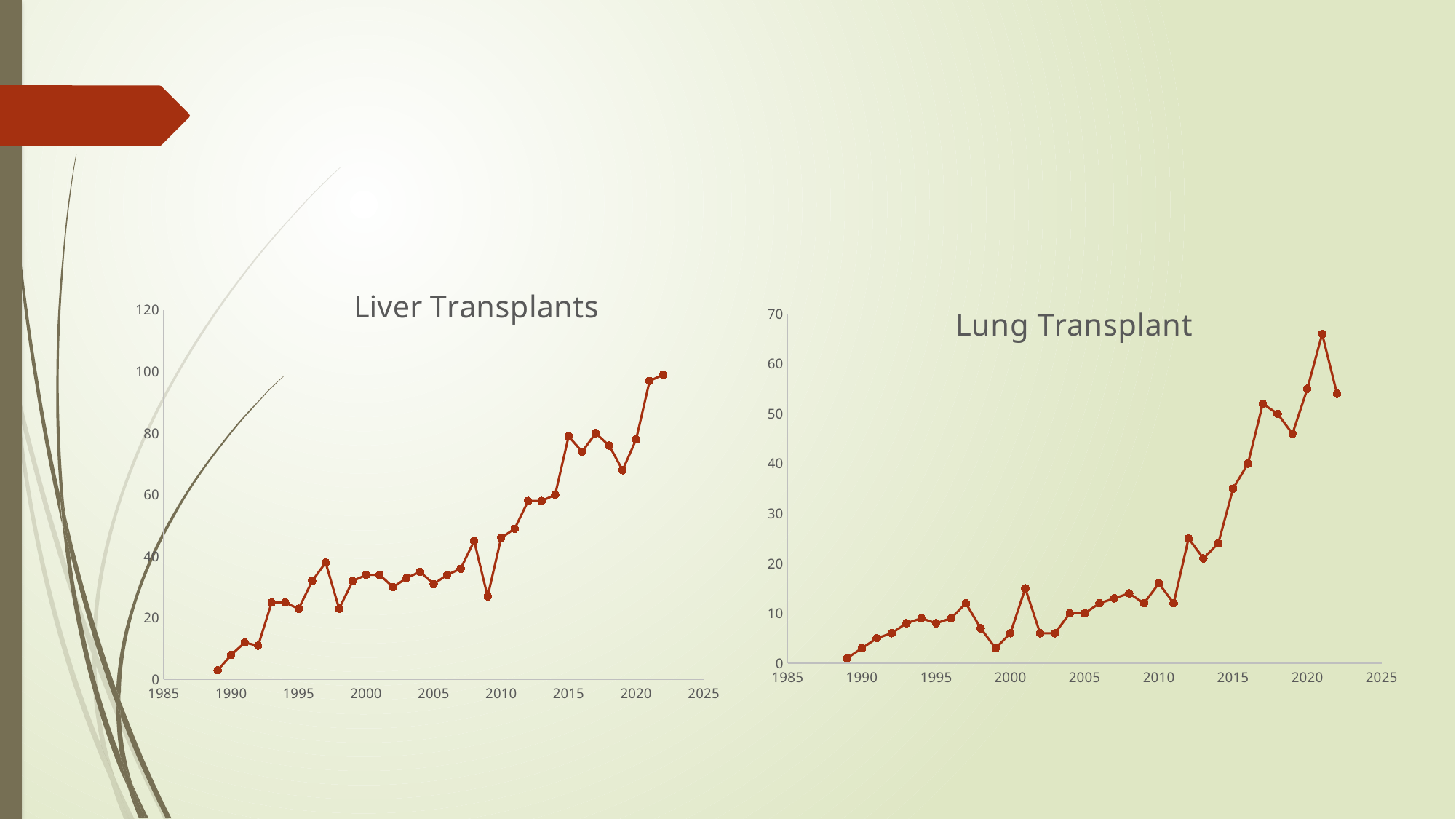
In the Lung Transplant chart, is the value for 2022 greater or less than 50? greater In the Lung Transplant chart, is the value for 1999 greater or less than 10? less In the Liver Transplants chart, which year has the lowest value? 1989 What kind of chart is the Lung Transplant chart? line chart In the Liver Transplants chart, do the values generally rise or fall from 1989 to 2022? rise In the Lung Transplant chart, which year has the lowest value? 1989 In the Lung Transplant chart, which is larger, the value for 2021 or the value for 2019? 2021 In the Lung Transplant chart, which year has the highest value? 2021 In the Liver Transplants chart, is the value for 2022 greater or less than 80? greater In the Lung Transplant chart, do the values generally rise or fall over the years shown? rise What kind of chart is the Liver Transplants chart? line chart